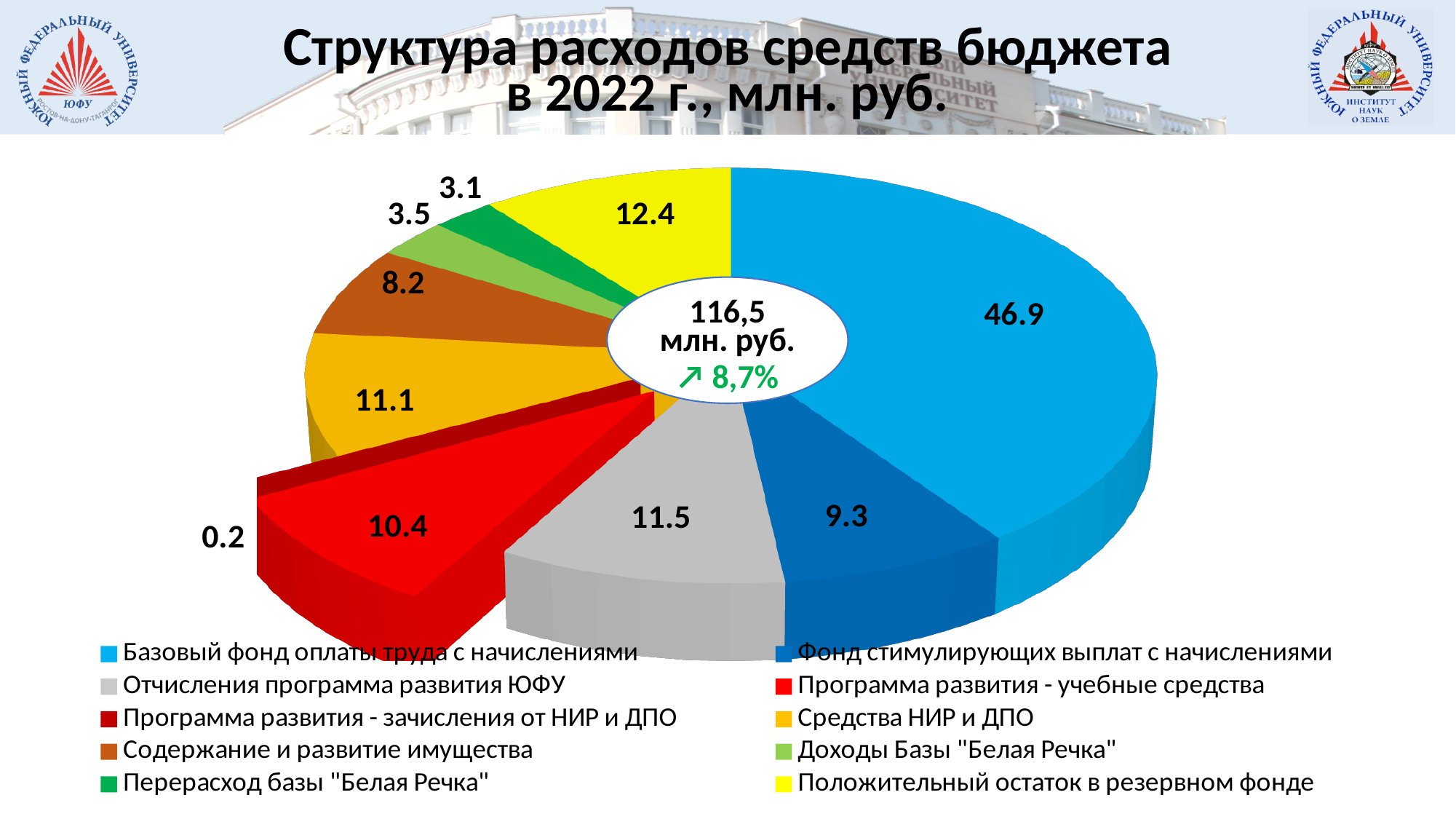
What is the difference between the values for Средства НИР и ДПО and Программа развития - учебные средства? 0.7 What is the value for Положительный остаток в резервном фонде? 12.4 What is the value for Отчисления программа развития ЮФУ? 11.5 Which is larger: Доходы Базы "Белая Речка" or Перерасход базы "Белая Речка"? Доходы Базы "Белая Речка" What is the difference between the values for Базовый фонд оплаты труда с начислениями and Фонд стимулирующих выплат с начислениями? 37.6 What is the value for Содержание и развитие имущества? 8.2 What is the value for Базовый фонд оплаты труда с начислениями? 46.9 What kind of chart is shown on the slide? pie chart Which category has the largest slice of the pie? Базовый фонд оплаты труда с начислениями How many categories does the pie chart have? 10 What total value is printed in the centre of the pie chart? 116,5 млн. руб. Which category has the smallest slice of the pie? Программа развития - зачисления от НИР и ДПО